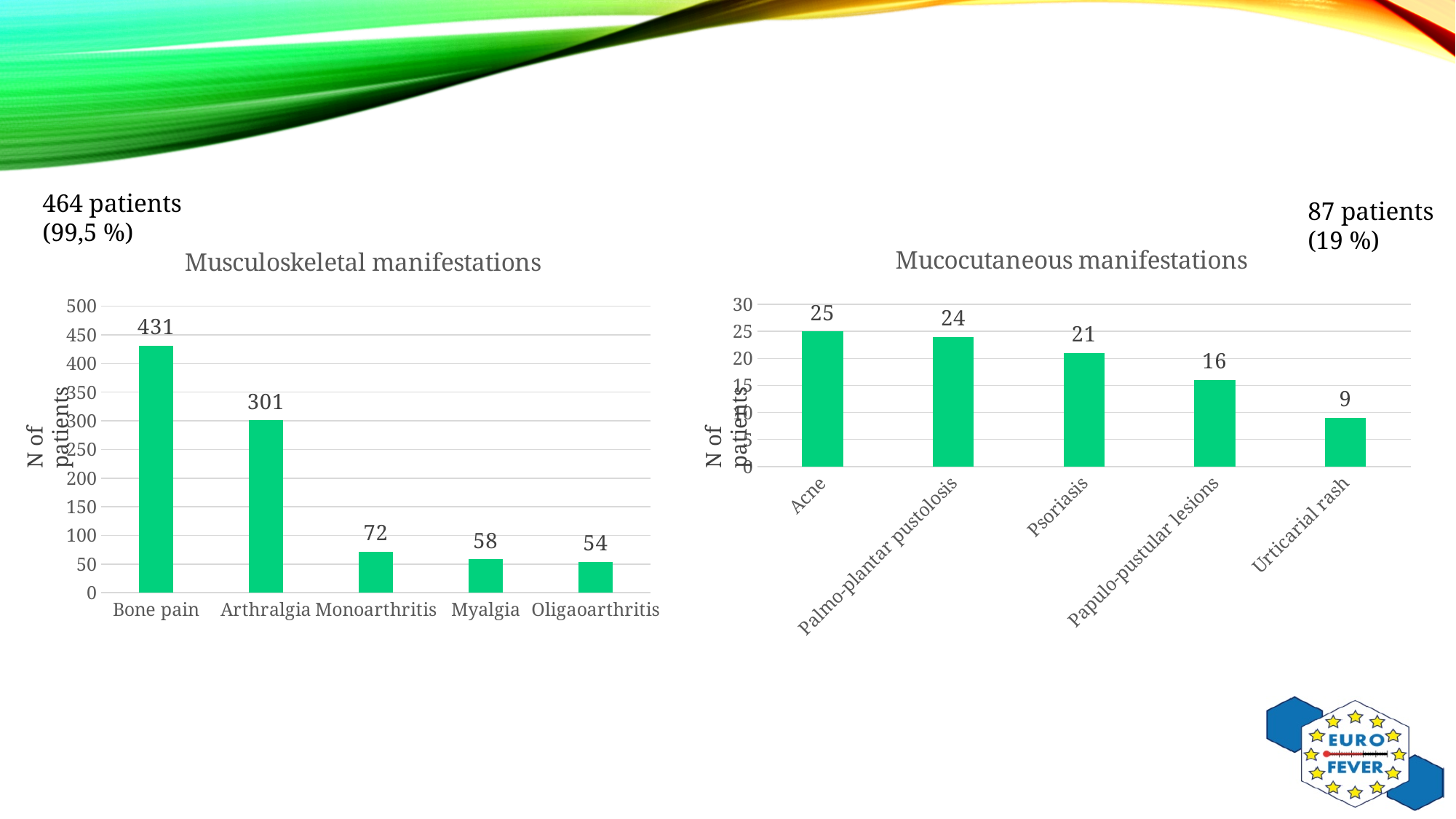
In the Mucocutaneous manifestations chart, what is the value for Urticarial rash? 9 In the Musculoskeletal manifestations chart, which category has the lowest value? Oligaoarthritis In the Mucocutaneous manifestations chart, which category has the highest value? Acne In the Musculoskeletal manifestations chart, how many categories are shown? 5 In the Musculoskeletal manifestations chart, what is the value for Arthralgia? 301 In the Musculoskeletal manifestations chart, which category has the highest value? Bone pain In the Mucocutaneous manifestations chart, do the values rise or fall from left to right? Fall In the Musculoskeletal manifestations chart, what is the difference between Bone pain and Arthralgia? 130 In the Mucocutaneous manifestations chart, what is the value for Psoriasis? 21 In the Mucocutaneous manifestations chart, which is larger, Papulo-pustular lesions or Urticarial rash? Papulo-pustular lesions What kind of chart is the Mucocutaneous manifestations chart? Bar chart In the Mucocutaneous manifestations chart, what is the difference between Acne and Papulo-pustular lesions? 9